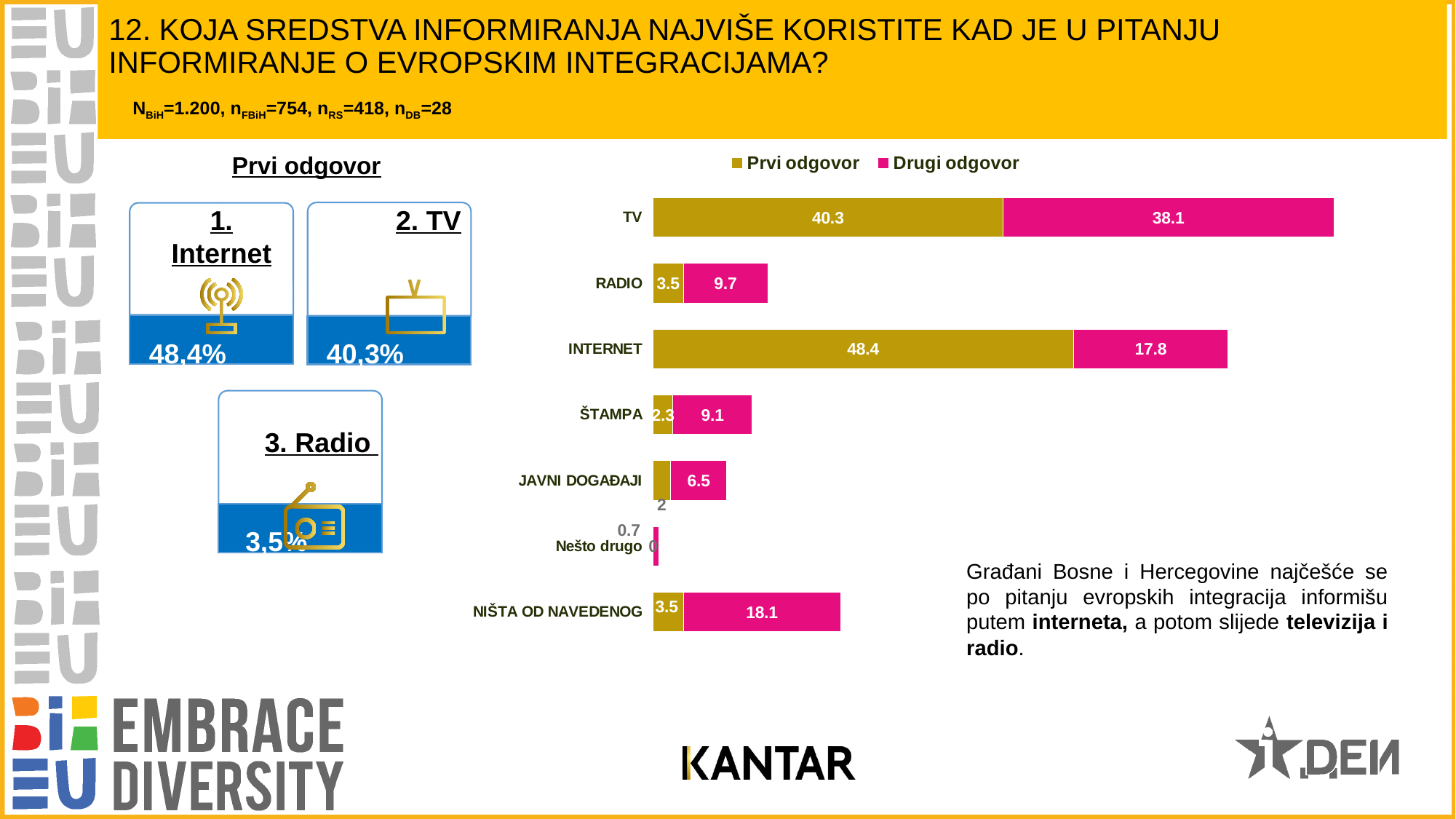
What is the Drugi odgovor value for NIŠTA OD NAVEDENOG? 18.1 How many series does the chart legend list? 2 What kind of chart is shown on the slide? bar chart Which category has the highest Prvi odgovor value? INTERNET Which colour represents the Drugi odgovor series in the chart? magenta (pink) Which category has the lowest Drugi odgovor value? Nešto drugo How many categories are plotted in the chart? 7 What is the total of the stacked bar for TV? 78.4 Which is larger for RADIO: the Prvi odgovor value or the Drugi odgovor value? Drugi odgovor What is the difference between the Prvi odgovor values for INTERNET and TV? 8.1 What is the Drugi odgovor value for TV? 38.1 What is the Prvi odgovor value for INTERNET? 48.4